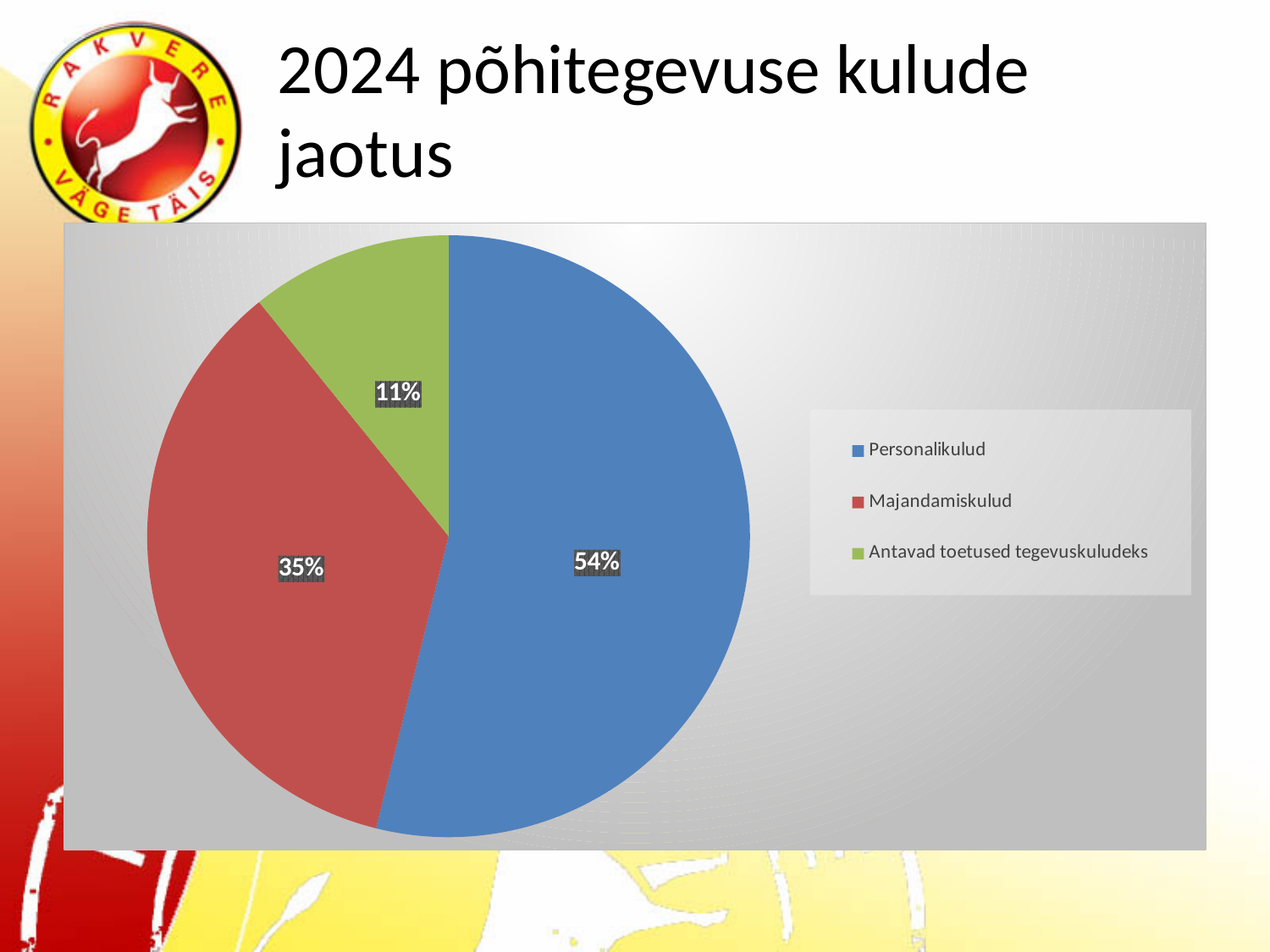
What share of the pie is Antavad toetused tegevuskuludeks? 11% What share of the pie is Majandamiskulud? 35% What colour is the Majandamiskulud slice? red Which category has the smallest slice of the pie? Antavad toetused tegevuskuludeks What is the title of the slide containing the chart? 2024 põhitegevuse kulude jaotus What kind of chart is shown on the slide? pie chart What is the difference in percentage points between Personalikulud and Majandamiskulud? 19 Which category has the largest slice of the pie? Personalikulud What share of the pie is Personalikulud? 54% How many slices does the pie chart have? 3 What is the difference in percentage points between Majandamiskulud and Antavad toetused tegevuskuludeks? 24 Which is larger, Majandamiskulud or Antavad toetused tegevuskuludeks? Majandamiskulud